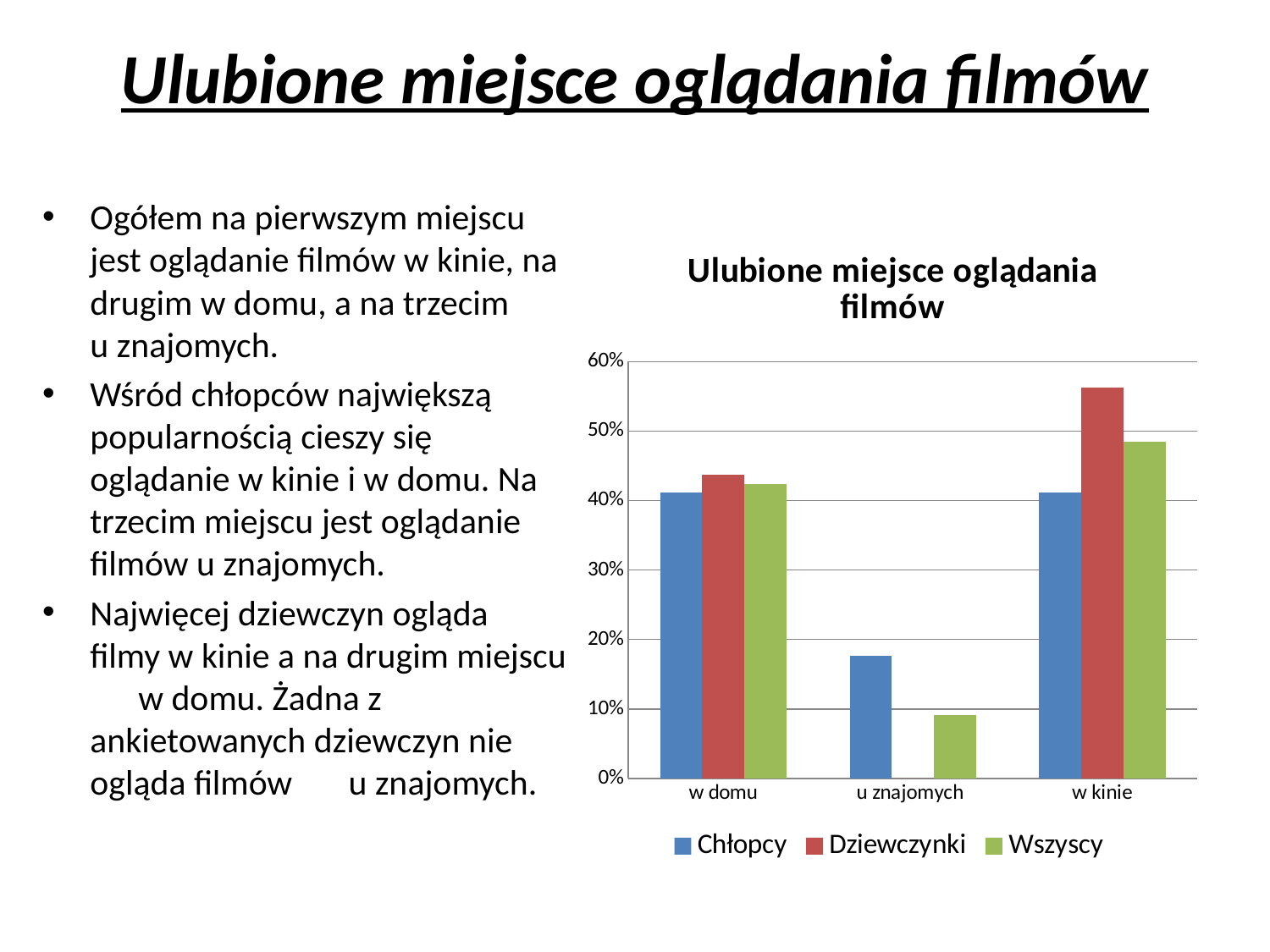
What kind of chart is shown on the slide? bar chart For the Wszyscy series, which category has the lowest value? u znajomych In the 'w kinie' category, which is larger: the value for Chłopcy or the value for Dziewczynki? Dziewczynki Which series is shown in red in the chart? Dziewczynki How many categories are shown on the x axis of the chart? 3 Is the value for Dziewczynki in the 'w kinie' category greater or less than 50%? greater Is the value for Wszyscy in the 'w domu' category greater or less than 40%? greater For the Dziewczynki series, which category has the highest value? w kinie What is the title of the chart? Ulubione miejsce oglądania filmów Is the value for Chłopcy in the 'u znajomych' category greater or less than 20%? less How many series does the chart legend list? 3